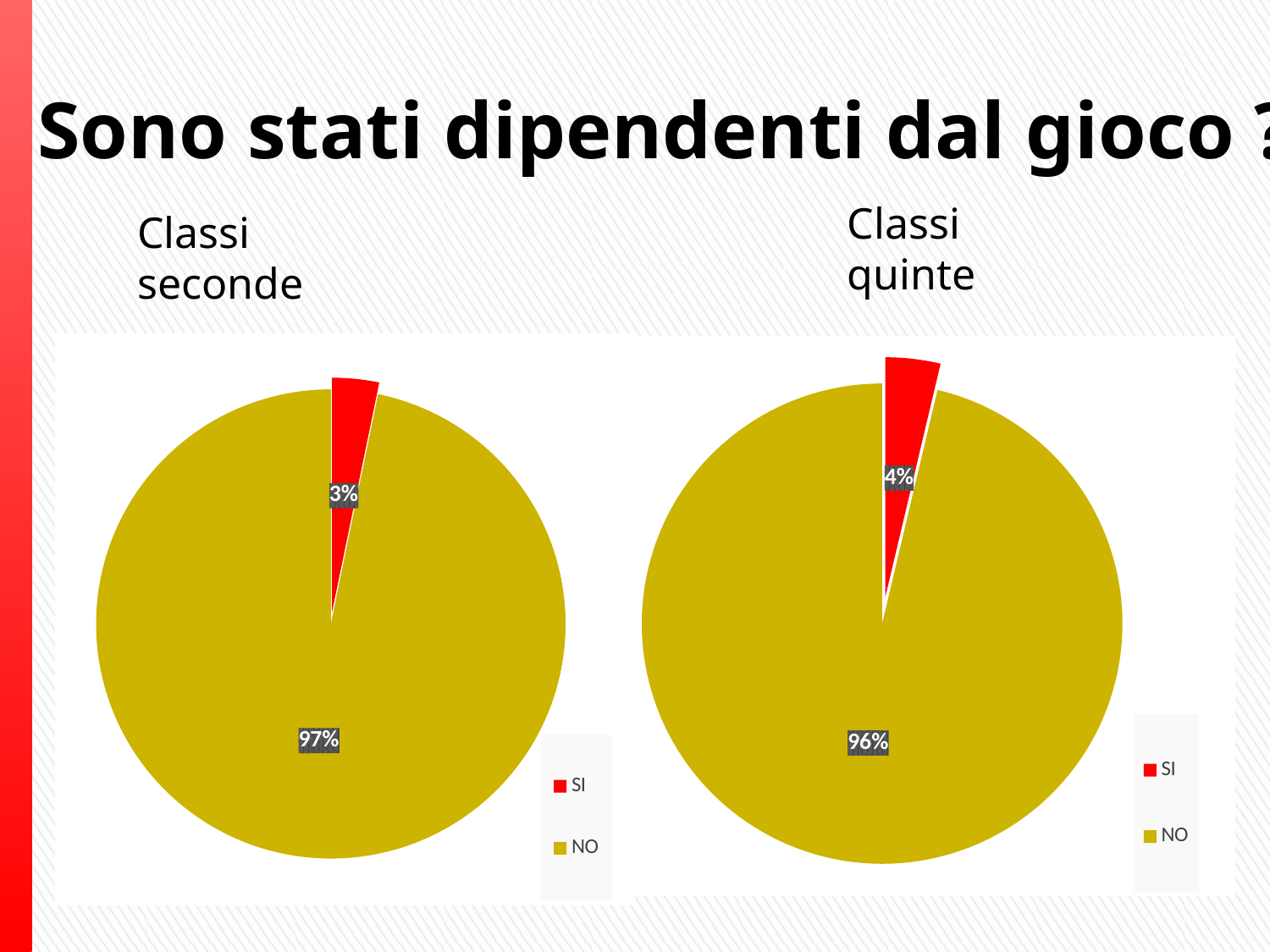
In the 'Classi quinte' pie chart, which category has the smallest slice? SI How many slices does the 'Classi quinte' pie chart have? 2 In the 'Classi quinte' pie chart, what percentage is shown for NO? 96% How many entries does the legend of the 'Classi seconde' chart list? 2 In the 'Classi quinte' chart, what colour represents SI? Red In the 'Classi seconde' pie chart, what percentage is shown for SI? 3% In the 'Classi seconde' pie chart, what percentage is shown for NO? 97% What type of chart is used for 'Classi seconde'? Pie chart Which chart shows a larger SI share, 'Classi seconde' or 'Classi quinte'? Classi quinte In the 'Classi seconde' pie chart, which category has the largest slice? NO In the 'Classi seconde' pie chart, what is the difference between the NO and SI percentages? 94% In the 'Classi quinte' pie chart, what percentage is shown for SI? 4%